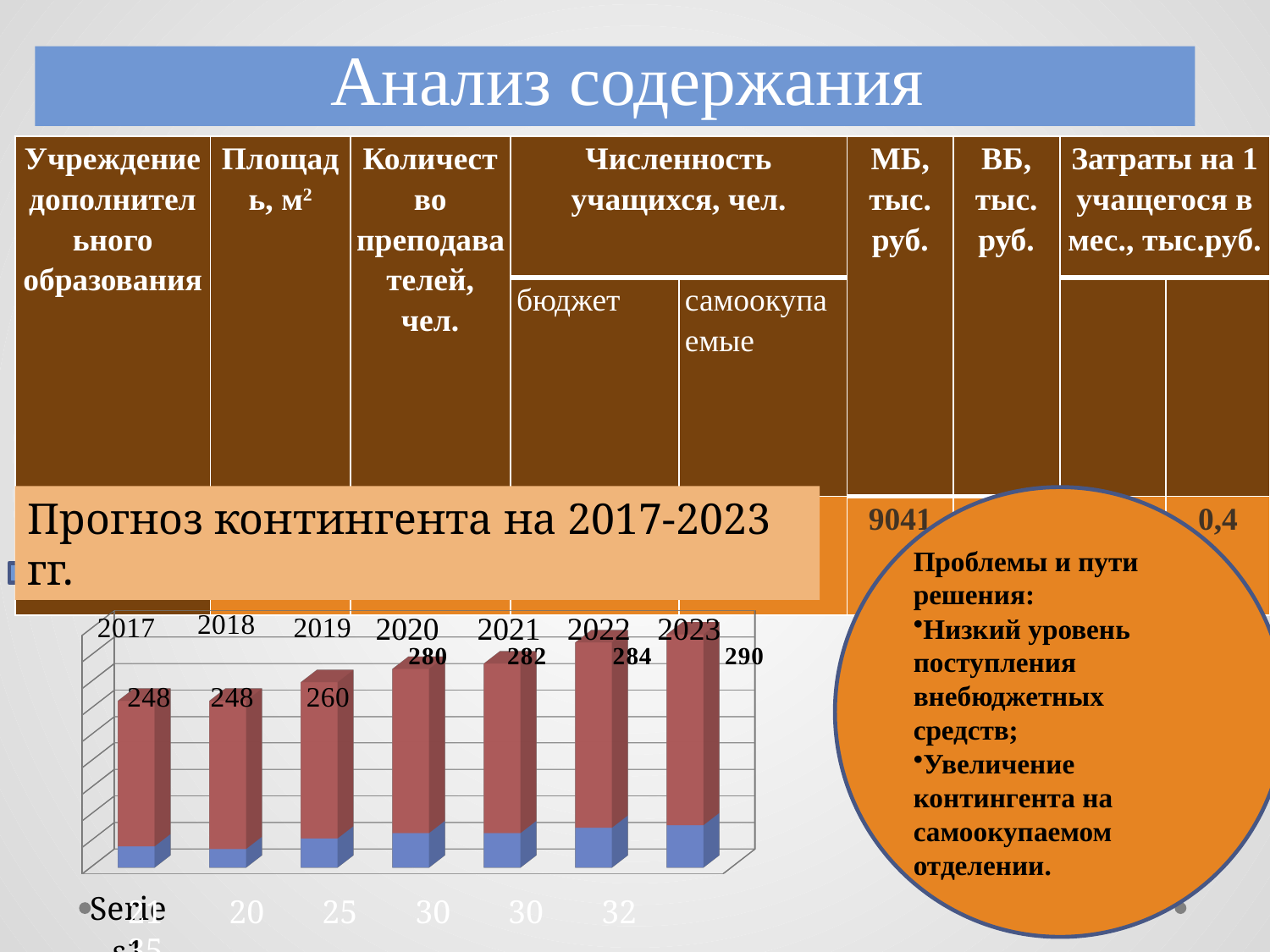
What is the difference between the red segment values for 2023 and 2017? 42 How many years are shown on the x axis of the chart? 7 Do the red segment values rise or fall from 2017 to 2023? rise What is the value of the red (upper) segment for 2021 in the chart? 282 Which year has the highest value for the red (upper) segment in the chart? 2023 What is the value of the red (upper) segment for 2017 in the chart 'Прогноз контингента на 2017-2023 гг.'? 248 What is the value of the red (upper) segment for 2019 in the chart? 260 What is the title of the chart on the slide? Прогноз контингента на 2017-2023 гг. Which year has the larger red segment value, 2019 or 2020? 2020 What is the difference between the red segment values for 2020 and 2019? 20 What kind of chart is shown on the slide? bar chart What is the value of the red (upper) segment for 2023 in the chart? 290